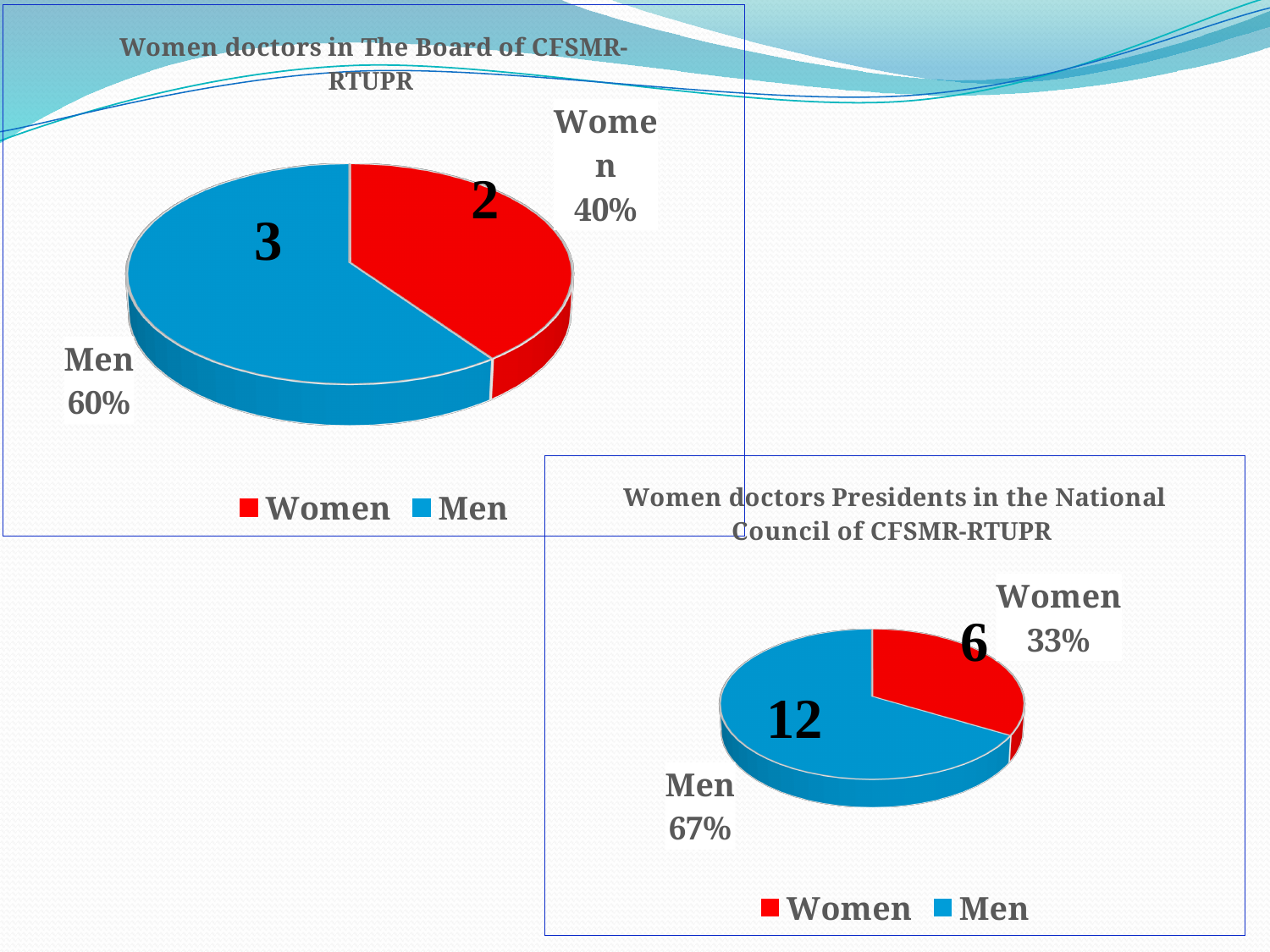
In the 'Women doctors Presidents in the National Council of CFSMR-RTUPR' chart, what share of the pie is Women? 33% How many categories does the legend of the 'Women doctors Presidents in the National Council of CFSMR-RTUPR' chart list? 2 What kind of chart is the 'Women doctors in The Board of CFSMR-RTUPR' chart? Pie chart In the 'Women doctors in The Board of CFSMR-RTUPR' chart, which category is the largest? Men In the 'Women doctors in The Board of CFSMR-RTUPR' chart, what is the value for Women? 2 In the 'Women doctors Presidents in the National Council of CFSMR-RTUPR' chart, what is the value for Women? 6 In the 'Women doctors in The Board of CFSMR-RTUPR' chart, what share of the pie is Men? 60% In the 'Women doctors in The Board of CFSMR-RTUPR' chart, what is the value for Men? 3 In the 'Women doctors in The Board of CFSMR-RTUPR' chart, what share of the pie is Women? 40% In the 'Women doctors Presidents in the National Council of CFSMR-RTUPR' chart, what is the difference between the values for Men and Women? 6 In the 'Women doctors Presidents in the National Council of CFSMR-RTUPR' chart, which category is the smallest? Women In the 'Women doctors Presidents in the National Council of CFSMR-RTUPR' chart, what is the value for Men? 12